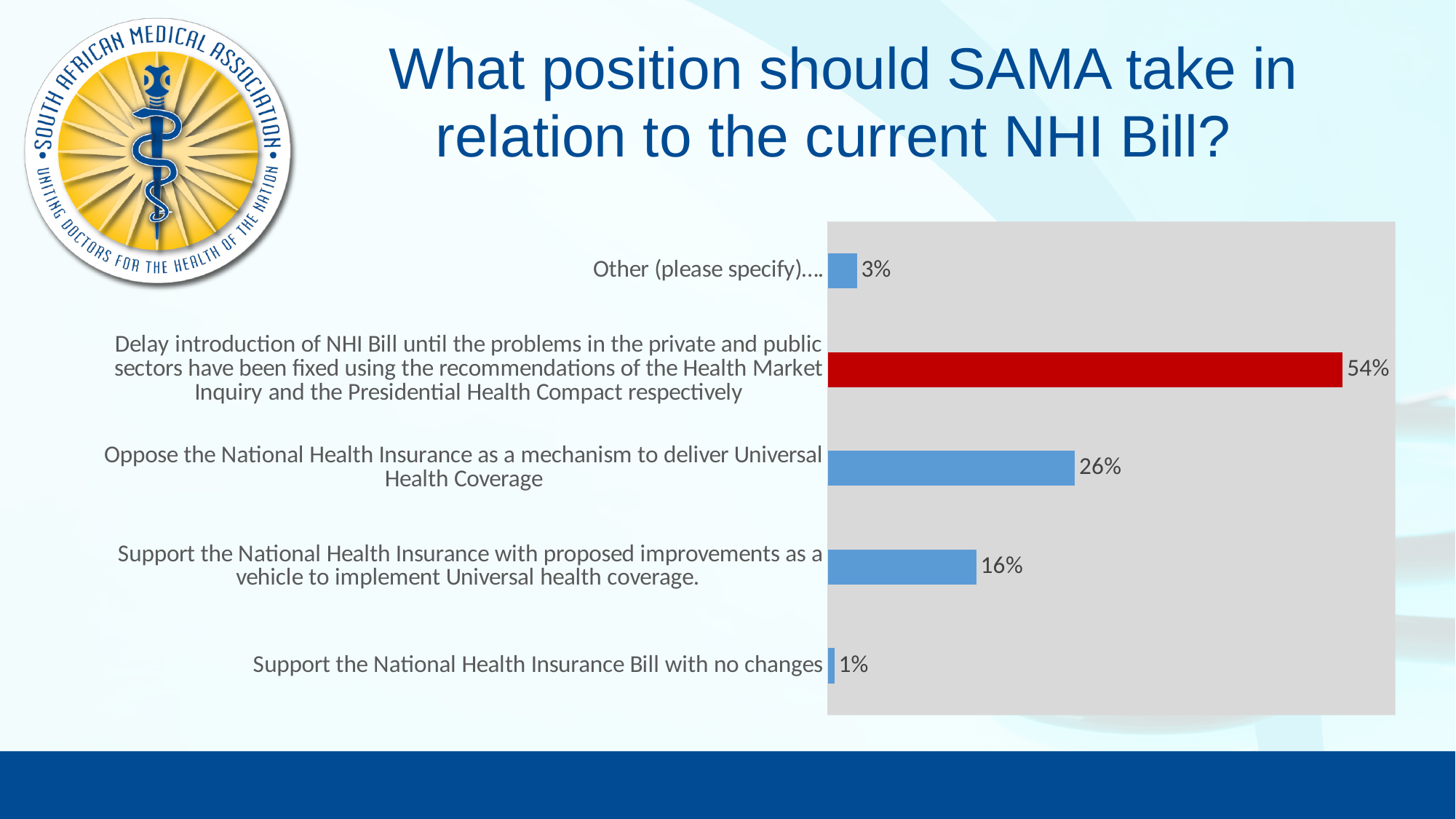
What percentage chose 'Oppose the National Health Insurance as a mechanism to deliver Universal Health Coverage'? 26% Which option received the lowest percentage of responses? Support the National Health Insurance Bill with no changes What percentage chose 'Support the National Health Insurance with proposed improvements as a vehicle to implement Universal health coverage'? 16% What type of chart is shown on the slide? Bar chart Which received a larger share: 'Oppose the National Health Insurance as a mechanism to deliver Universal Health Coverage' or 'Support the National Health Insurance with proposed improvements'? Oppose the National Health Insurance as a mechanism to deliver Universal Health Coverage What is the difference in percentage points between the 'Delay introduction of NHI Bill' option and the 'Oppose the National Health Insurance' option? 28 What percentage chose 'Other (please specify)'? 3% How many response options are shown in the chart? 5 What is the difference in percentage points between 'Support the National Health Insurance with proposed improvements' and 'Other (please specify)'? 13 What percentage of respondents chose 'Support the National Health Insurance Bill with no changes'? 1%